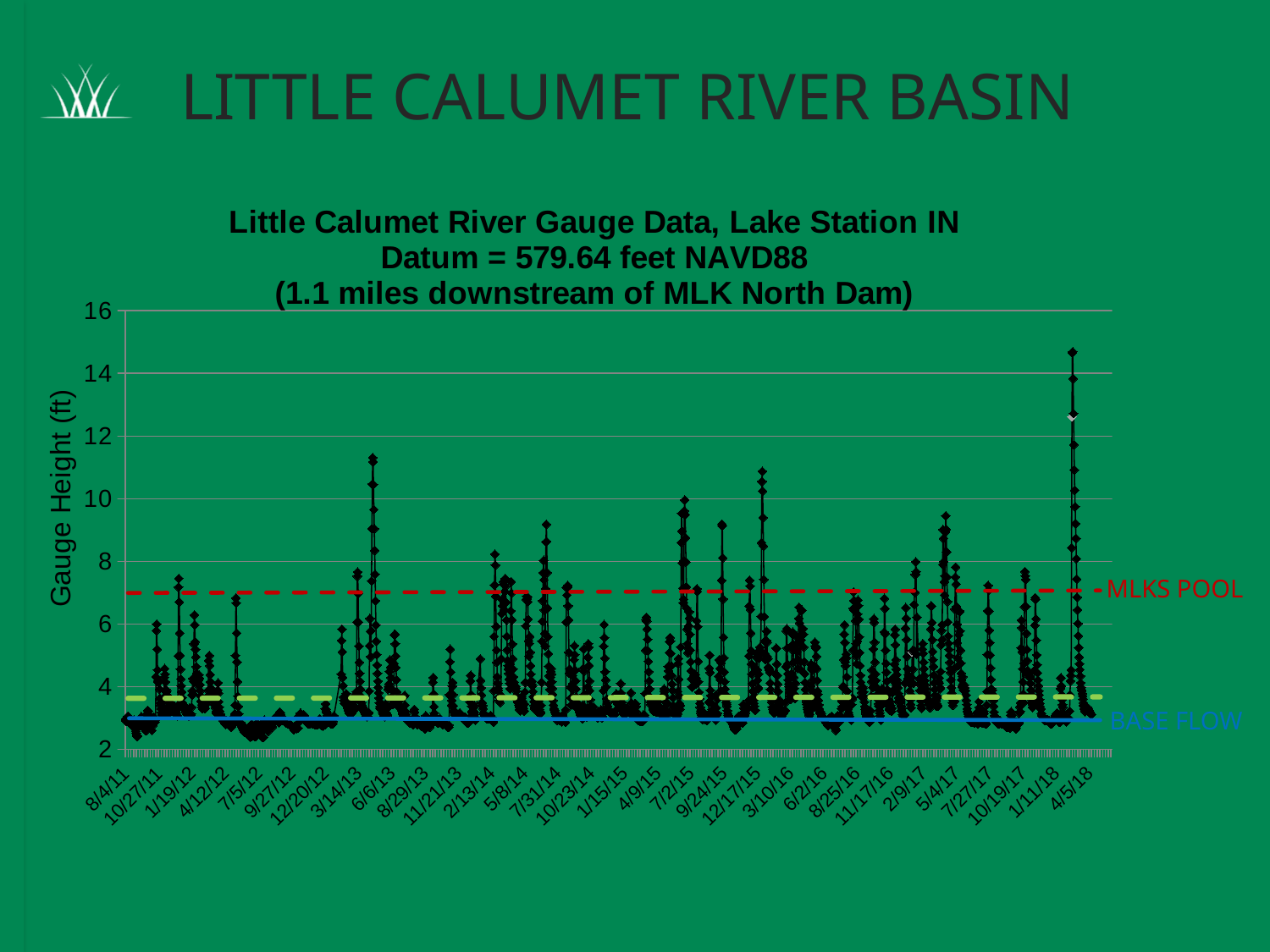
Which is higher on the chart, the MLKS POOL line or the BASE FLOW line? MLKS POOL What does the red dashed horizontal line on the chart represent? MLKS POOL Is the MLKS POOL line greater or less than 8 on the Gauge Height axis? less Is the MLKS POOL line greater or less than 6 on the Gauge Height axis? greater What is the title of the chart? Little Calumet River Gauge Data, Lake Station IN Datum = 579.64 feet NAVD88 (1.1 miles downstream of MLK North Dam) What kind of chart is shown on the slide? line chart Is the gauge height peak near 7/2/15 greater or less than 8? greater Which is higher on the chart, the peak near 6/6/13 or the peak near 8/29/13? the peak near 6/6/13